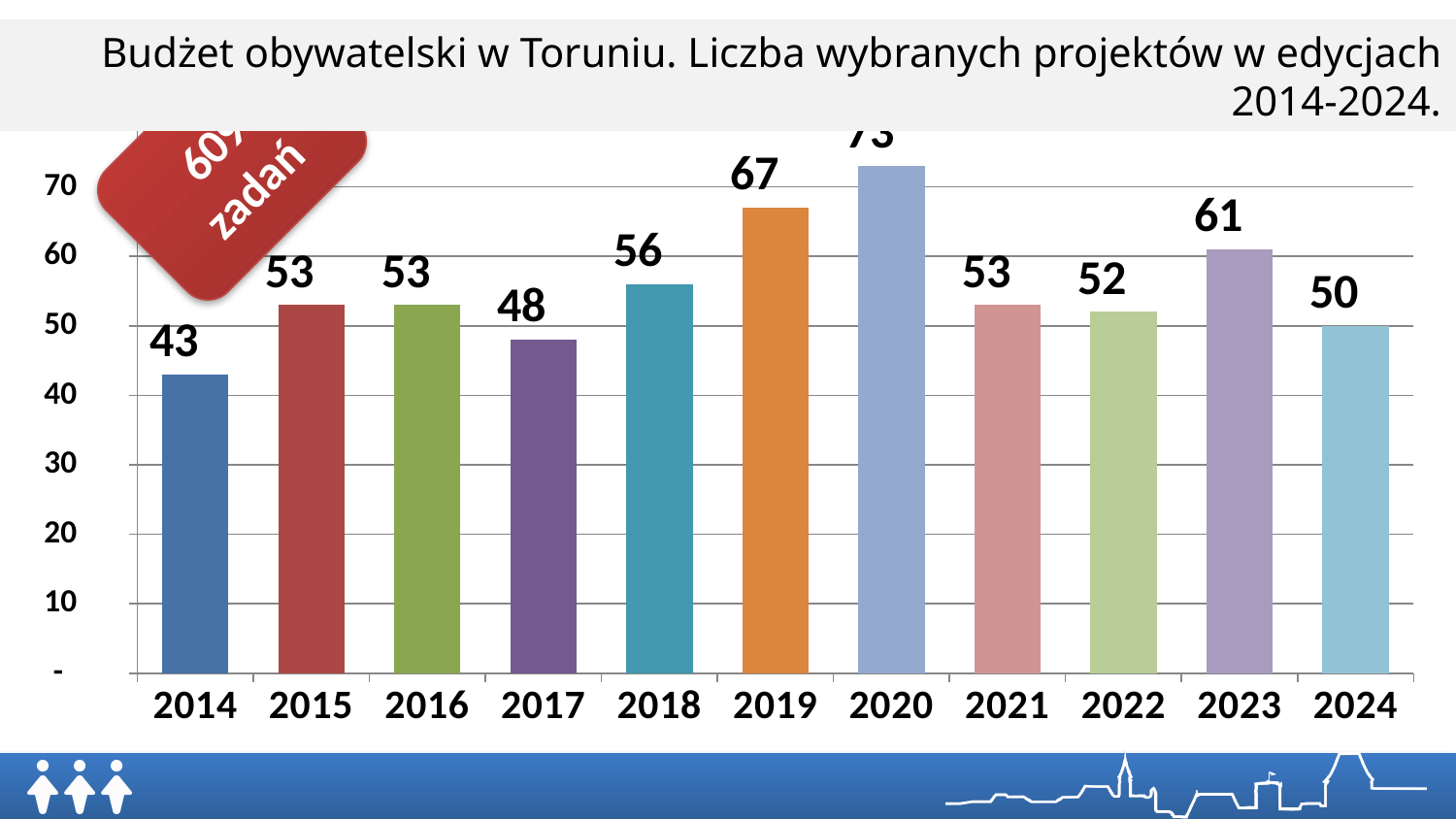
What is the value for 2023? 61 Which is larger, the value for 2023 or the value for 2024? 2023 Which year has the lowest value? 2014 What is the difference between the values for 2019 and 2018? 11 What is the value for 2017? 48 Does the value rise or fall from 2014 to 2015? rise Which year has the highest value? 2020 What is the value for 2014? 43 What kind of chart is shown on the slide? bar chart What is the value for 2019? 67 How many years are shown on the x axis? 11 Is the value for 2020 greater or less than 70? greater